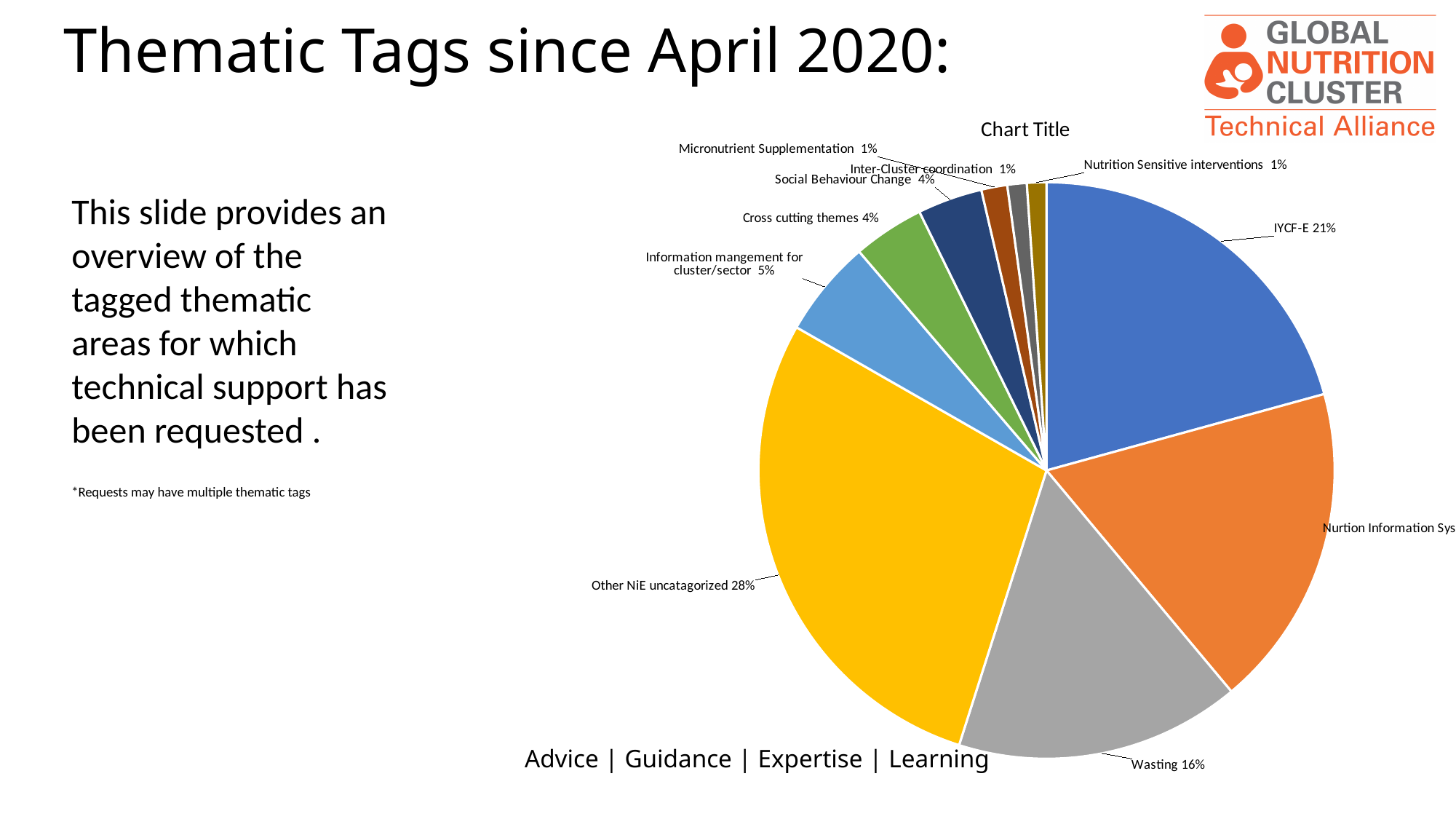
What percentage is shown for Wasting? 16% What kind of chart is shown on the slide? pie chart What percentage is shown for Cross cutting themes? 4% Which is larger, the share for IYCF-E or the share for Wasting? IYCF-E What percentage is shown for Other NiE uncatagorized? 28% By how many percentage points does IYCF-E exceed Wasting? 5 What percentage is shown for Micronutrient Supplementation? 1% Which category has the largest slice of the pie? Other NiE uncatagorized How many slices does the pie chart have? 10 What is the title shown above the pie chart? Chart Title What share of the pie does IYCF-E account for? 21% What percentage is shown for Information mangement for cluster/sector? 5%